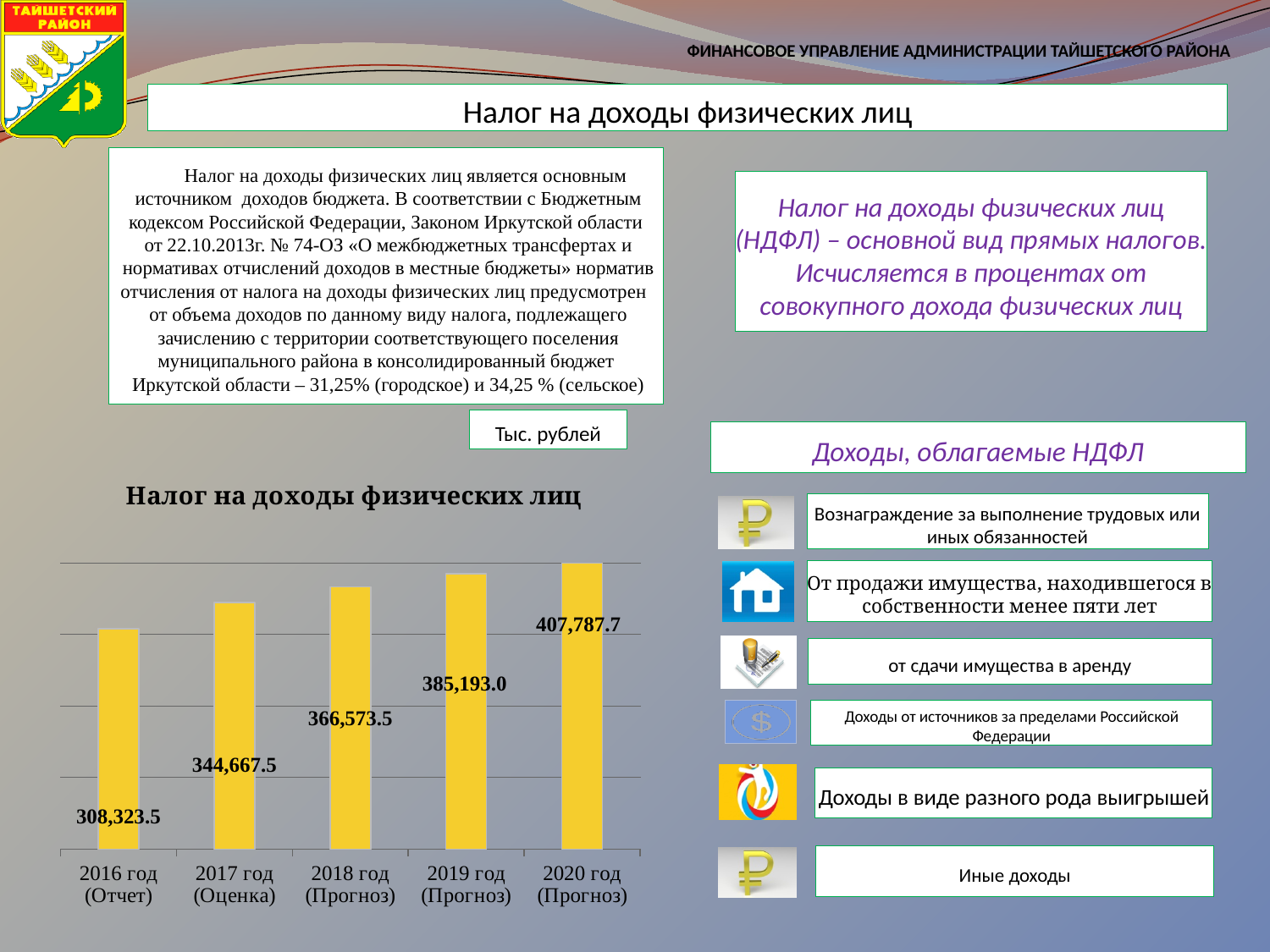
How many years are shown in the chart? 5 Do the values rise or fall from 2016 to 2020? Rise What is the value for 2016 год (Отчет)? 308,323.5 What is the difference between the values for 2020 год (Прогноз) and 2016 год (Отчет)? 99,464.2 What is the value for 2017 год (Оценка)? 344,667.5 What is the value for 2018 год (Прогноз)? 366,573.5 What type of chart is shown on the slide? Bar chart What is the value for 2019 год (Прогноз)? 385,193.0 Which year has the highest value? 2020 год (Прогноз) Which is larger, the value for 2018 год (Прогноз) or 2019 год (Прогноз)? 2019 год (Прогноз) What is the value for 2020 год (Прогноз)? 407,787.7 Which year has the lowest value? 2016 год (Отчет)